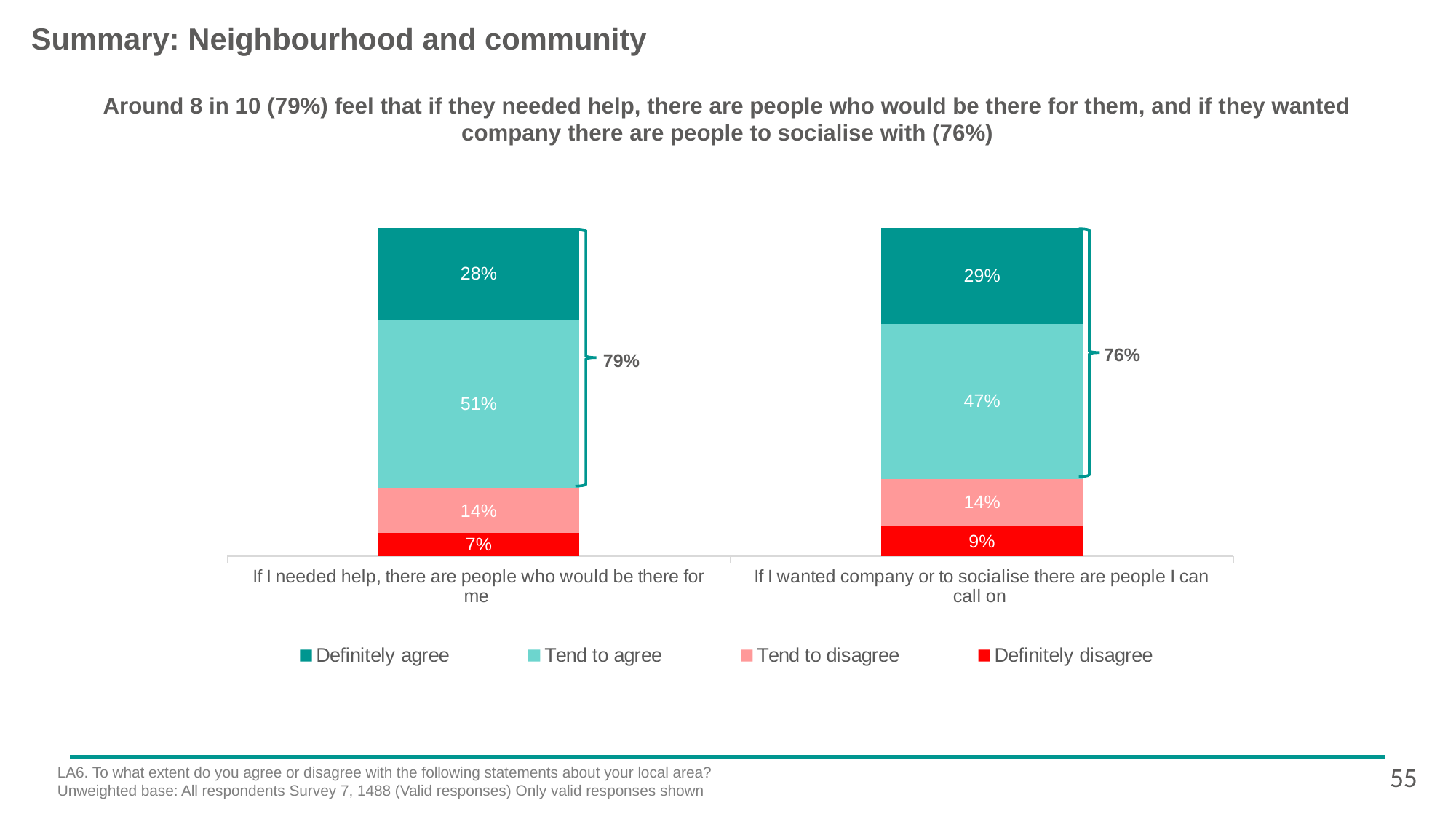
How many series does the legend list? 4 What percentage of respondents 'Tend to disagree' that if they needed help, there are people who would be there for them? 14% What percentage of respondents 'Definitely disagree' that if they wanted company or to socialise there are people they can call on? 9% What is the difference between the 'Tend to agree' percentages for the two statements? 4 percentage points What percentage of respondents 'Tend to agree' that if they wanted company or to socialise there are people they can call on? 47% What is the combined agreement percentage shown by the bracket for 'If I wanted company or to socialise there are people I can call on'? 76% Which statement has the higher 'Definitely disagree' percentage? If I wanted company or to socialise there are people I can call on What percentage of respondents 'Definitely agree' that if they needed help, there are people who would be there for them? 28% Which legend entry is shown in bright red? Definitely disagree What is the combined agreement percentage shown by the bracket for 'If I needed help, there are people who would be there for me'? 79% How many statements (categories) are shown on the x axis? 2 What kind of chart is shown on the slide? Stacked bar chart